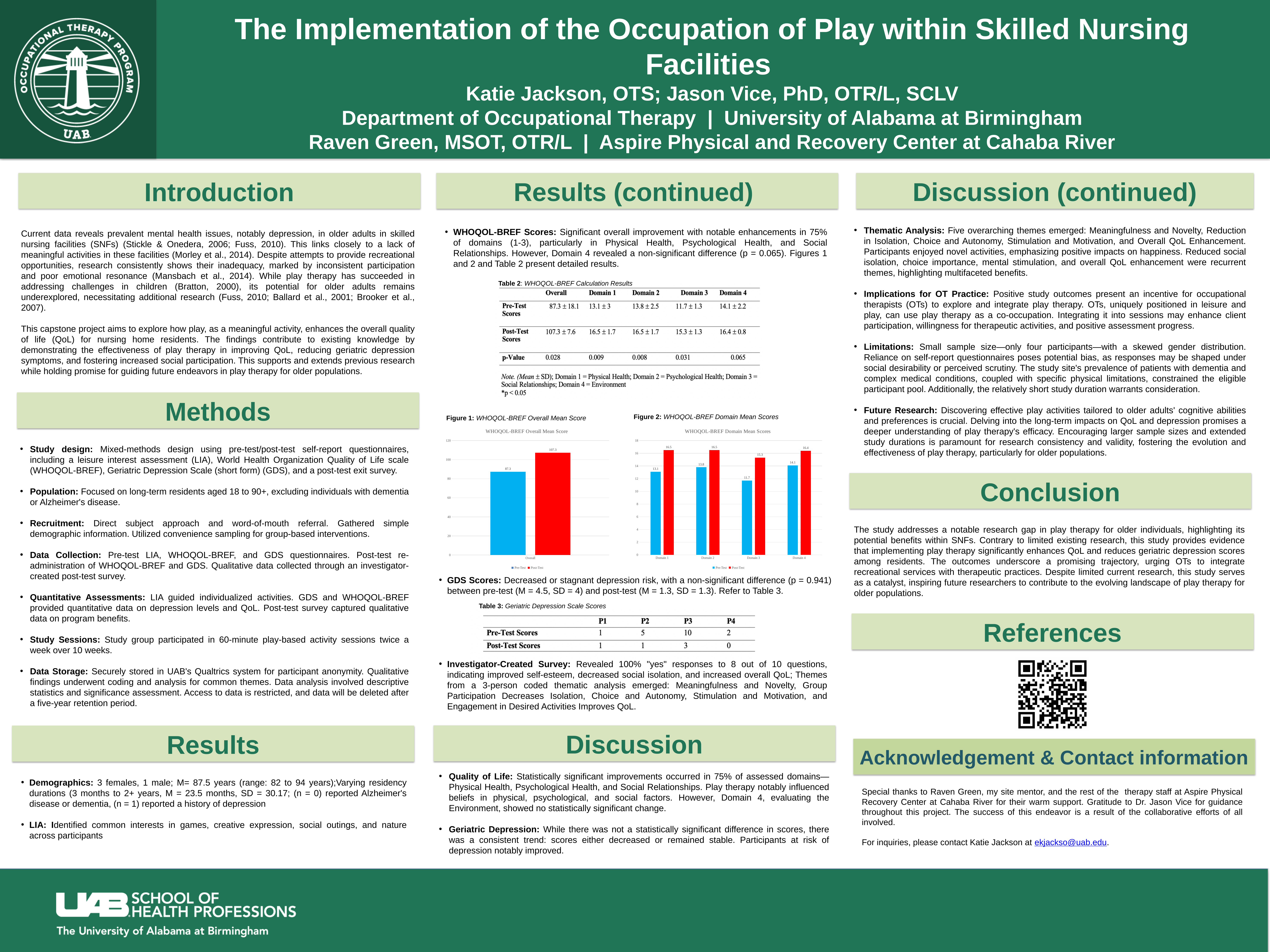
In the WHOQOL-BREF Domain Mean Scores chart, which domain has the lowest Pre-Test value? Domain 3 In the WHOQOL-BREF Domain Mean Scores chart, which is larger for Domain 2: the Pre-Test or the Post-Test value? Post-Test In the WHOQOL-BREF Overall Mean Score chart, is the Pre-Test value greater or less than 100? less What kind of chart is the WHOQOL-BREF Domain Mean Scores chart? bar chart In the WHOQOL-BREF Domain Mean Scores chart, which domain has the highest Pre-Test value? Domain 4 In the WHOQOL-BREF Domain Mean Scores chart, what is the Post-Test value for Domain 4? 16.4 In the WHOQOL-BREF Domain Mean Scores chart, how many domains are shown on the x axis? 4 In the WHOQOL-BREF Overall Mean Score chart, what is the difference between the Post-Test and Pre-Test values? 20.0 How many series does the legend of the WHOQOL-BREF Domain Mean Scores chart list? 2 In the WHOQOL-BREF Overall Mean Score chart, what is the Pre-Test value? 87.3 In the WHOQOL-BREF Overall Mean Score chart, what is the Post-Test value? 107.3 In the WHOQOL-BREF Domain Mean Scores chart, what is the Pre-Test value for Domain 3? 11.7